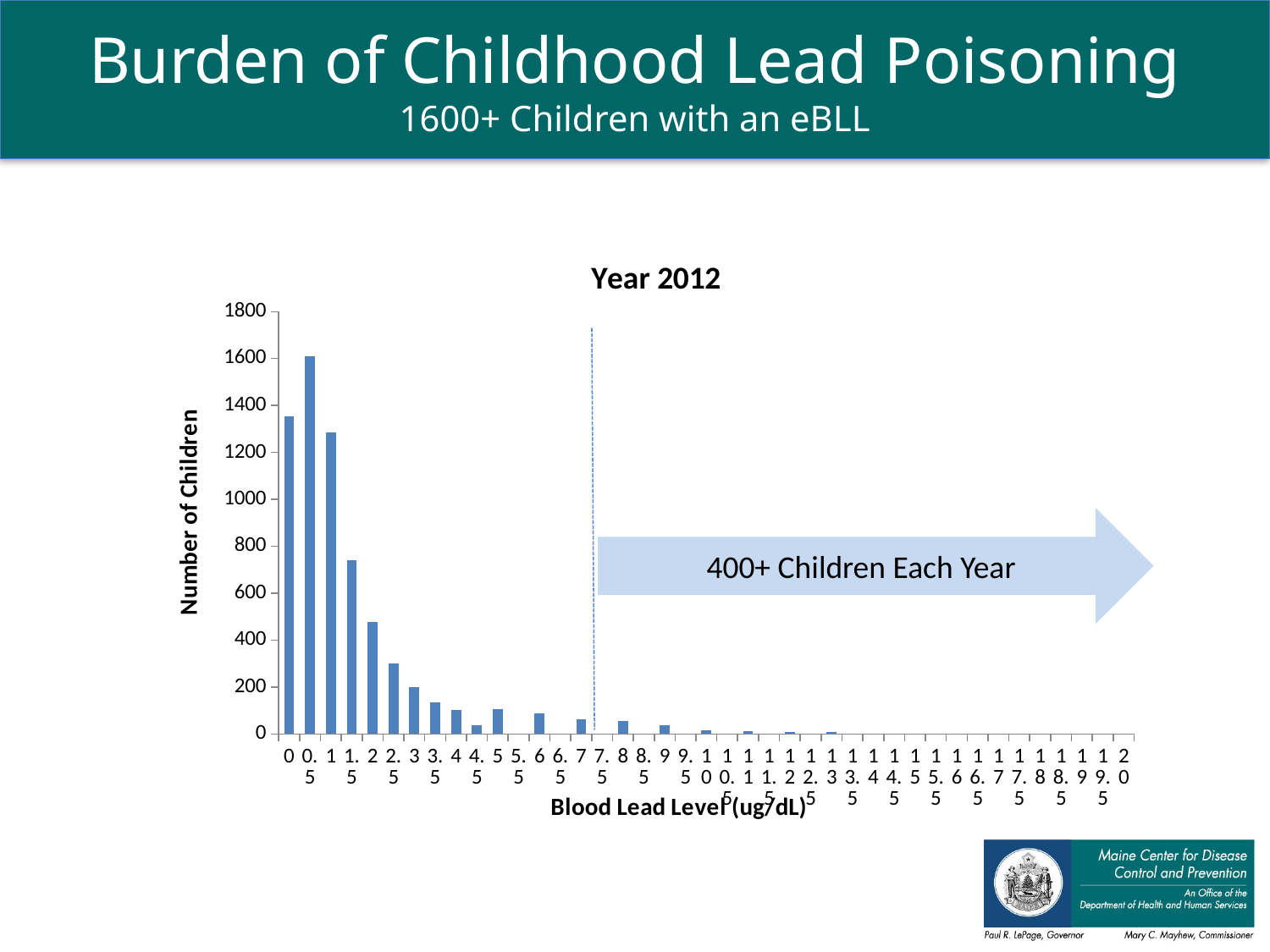
Is the number of children at blood lead level 1.5 greater or less than 800? less What is the title of the chart? Year 2012 Is the number of children at blood lead level 2.5 greater or less than 400? less Beyond blood lead level 0.5, do the bars generally rise or fall as the blood lead level increases? fall What is the label of the vertical axis? Number of Children Which has more children, blood lead level 1.5 or blood lead level 2? 1.5 Is the number of children at blood lead level 2 greater or less than 600? less Which has more children, blood lead level 0 or blood lead level 1? 0 What kind of chart is shown on the slide? bar chart Which blood lead level category has the highest number of children? 0.5